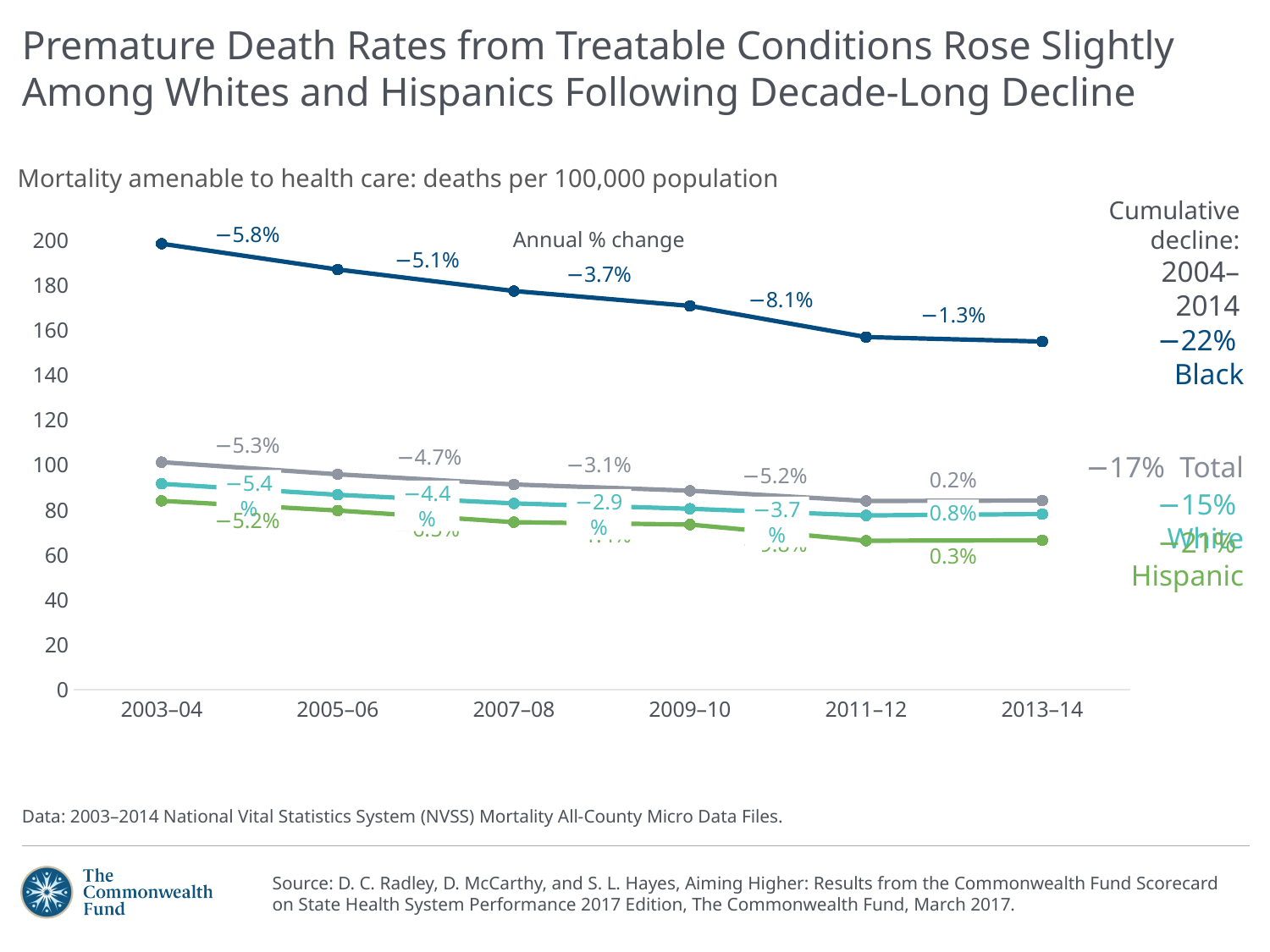
Is the value for Hispanic in 2013–14 greater or less than 80? less Which group has the highest mortality rate in 2003–04? Black What is the cumulative decline from 2004 to 2014 shown for the Black group? −22% Which group has the lowest mortality rate in 2013–14? Hispanic How many population groups (lines) are plotted on the chart? 4 Is the value for Black in 2013–14 greater or less than 160? less Does the Black line rise or fall from 2003–04 to 2013–14? fall What annual % change is labeled on the Black line between 2009–10 and 2011–12? −8.1% How many time periods are shown on the x axis? 6 What annual % change is labeled on the Total line between 2011–12 and 2013–14? 0.2% Is the value for Black in 2003–04 greater or less than 180? greater What kind of chart is shown on the slide? line chart